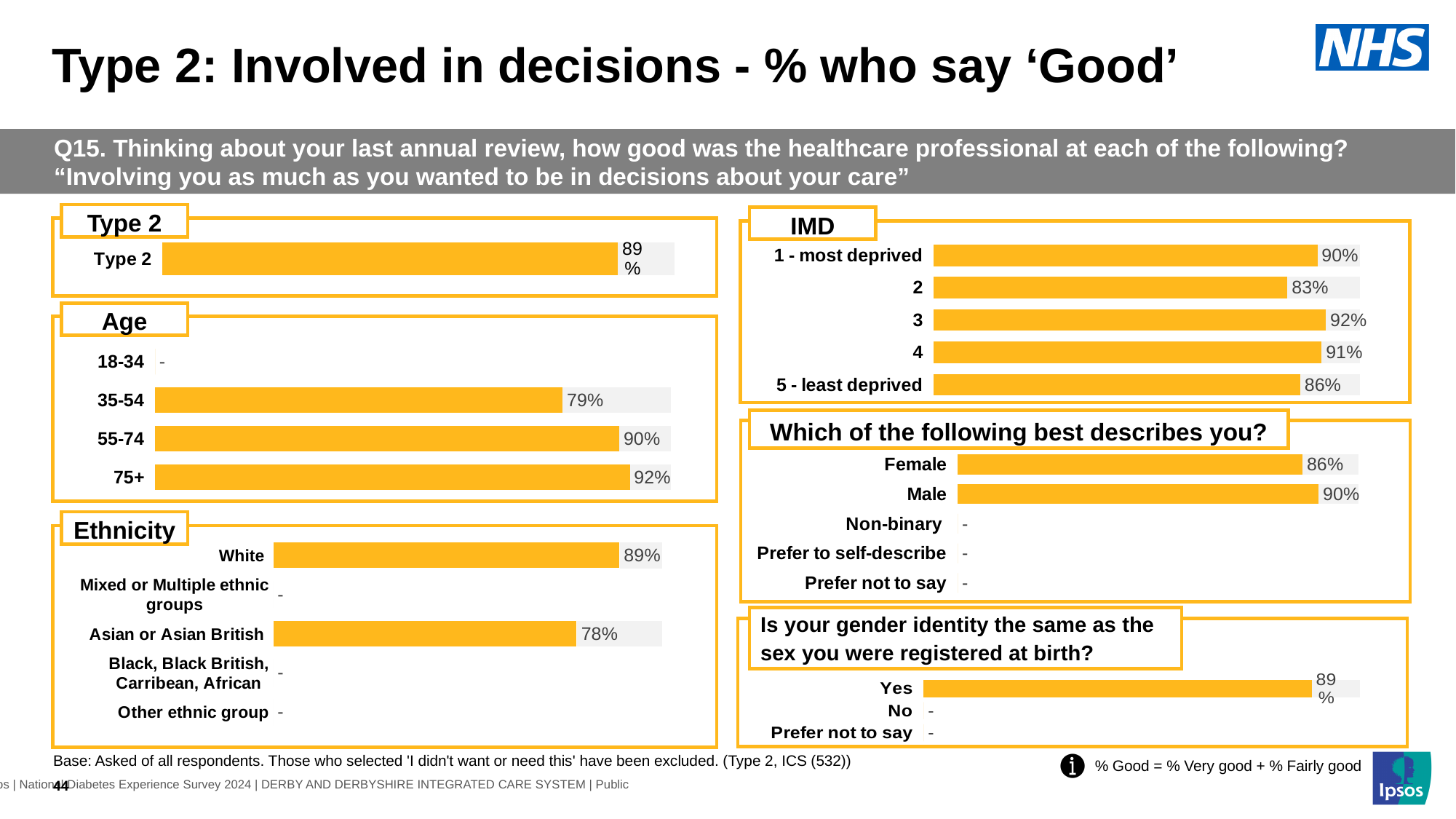
In the Age chart, which age group has the highest value? 75+ In the IMD chart, which category has the highest value? 3 In the IMD chart, which category has the lowest value? 2 In the Ethnicity chart, which is larger, the value for White or the value for Asian or Asian British? White In the Age chart, what is the difference between the values for 75+ and 35-54? 13 percentage points In the 'Is your gender identity the same as the sex you were registered at birth?' chart, what is the value for Yes? 89% In the Ethnicity chart, what is the value for Asian or Asian British? 78% In the IMD chart, how many categories are shown? 5 In the IMD chart, what is the value for 2? 83% In the Type 2 chart, what is the value for Type 2? 89% In the 'Which of the following best describes you?' chart, what is the difference between the values for Male and Female? 4 percentage points In the Age chart, what is the value for 35-54? 79%